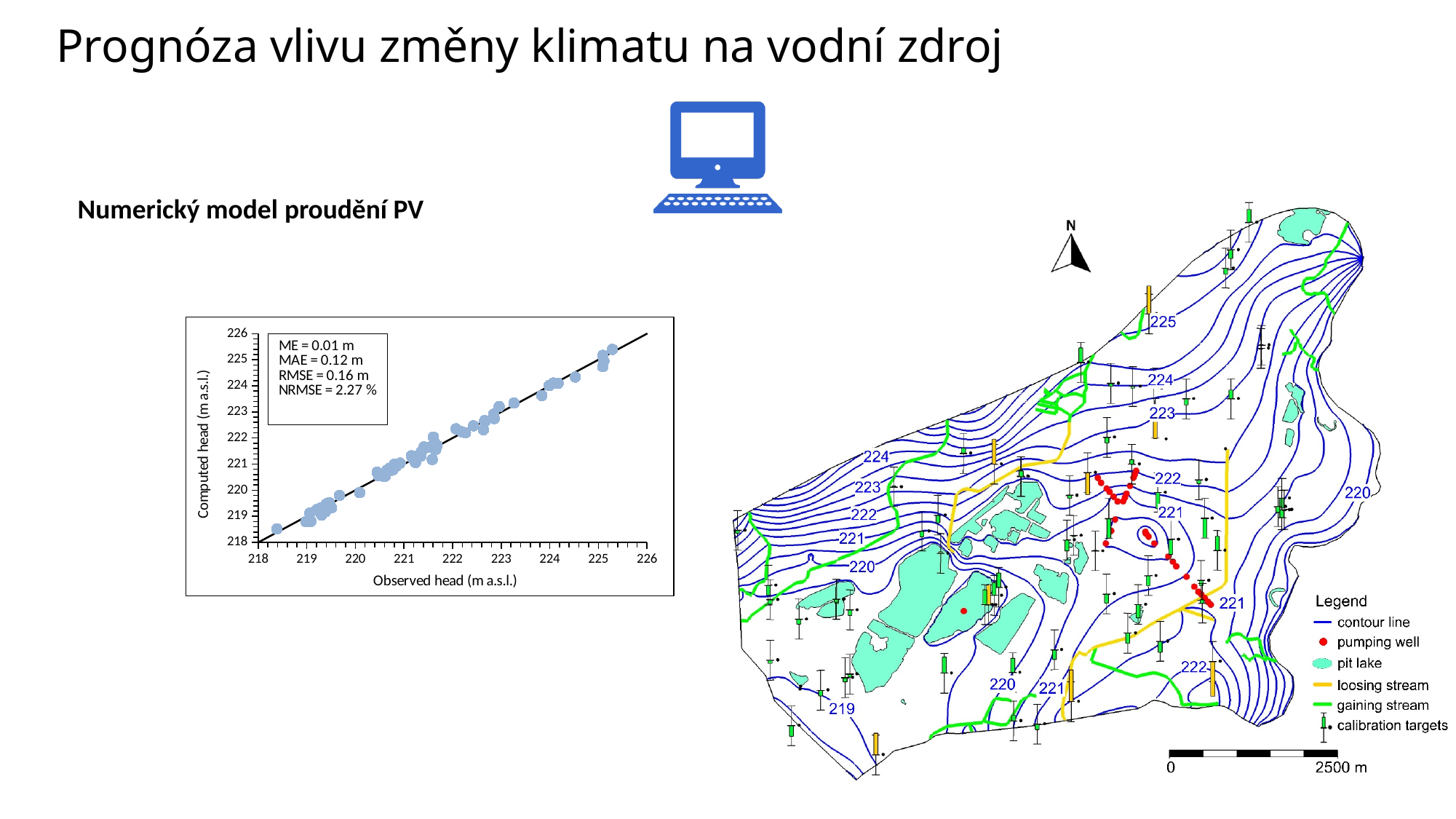
On the scatter chart on the left, is the computed head of the highest point greater or less than 225? greater On the scatter chart on the left, what is the maximum value shown on the x axis? 226 On the scatter chart on the left, do the computed head values rise or fall as the observed head increases along the x axis? rise On the scatter chart on the left, what is the RMSE value printed in the text box? 0.16 m On the map on the right, how many entries does the legend list? 6 On the scatter chart on the left, is the observed head of the lowest point greater or less than 219? less On the scatter chart on the left, what is the label of the x axis? Observed head (m a.s.l.) On the scatter chart on the left, what is the NRMSE value printed in the text box? 2.27 % On the scatter chart on the left, what is the MAE value printed in the text box? 0.12 m On the scatter chart on the left, what is the ME value printed in the text box? 0.01 m On the scatter chart on the left, what is the label of the y axis? Computed head (m a.s.l.) What kind of chart is the chart on the left of the slide (Computed head vs Observed head)? scatter chart